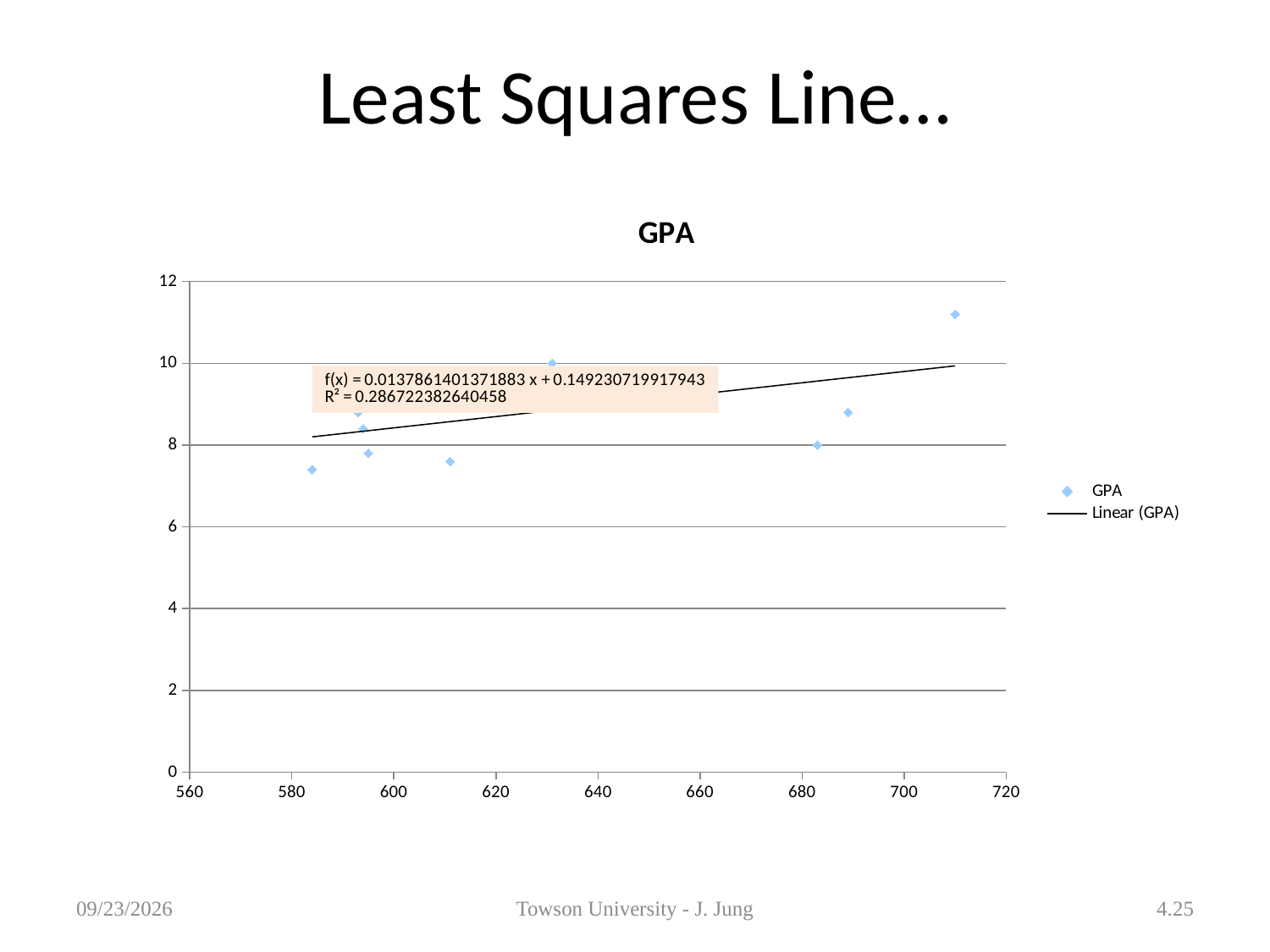
Is the GPA value of the point near x = 710 greater or less than 10? greater Is the GPA value of the point near x = 584 greater or less than 8? less Is the GPA value of the point near x = 710 greater or less than 12? less Which is larger: the GPA value of the point near x = 631 or the point near x = 683? the point near x = 631 What R² value is printed on the chart? R² = 0.286722382640458 What is the title of the chart? GPA What kind of chart is shown on the slide? scatter chart Which data point has the highest GPA value: the one near x = 710 or the one near x = 689? the one near x = 710 How many entries does the chart legend list? 2 Do the GPA values generally rise or fall as the x-axis value increases, according to the fitted line? rise